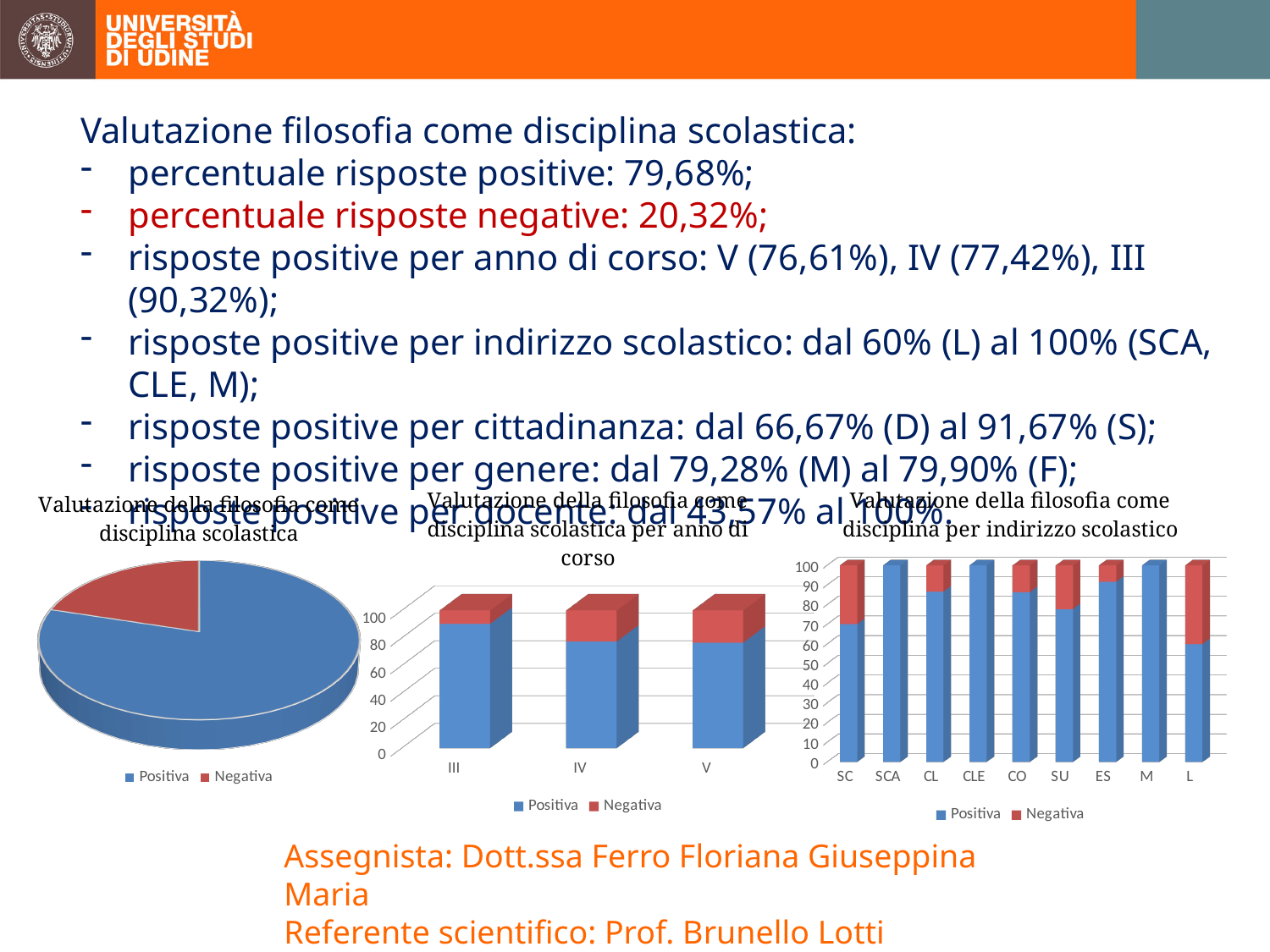
In the right chart (per indirizzo scolastico), how many categories are shown on the x axis? 9 In the right chart (per indirizzo scolastico), which category has the lowest Positiva value? L What kind of chart is the left chart titled 'Valutazione della filosofia come disciplina scolastica'? pie chart In the middle chart (per anno di corso), how many categories are shown on the x axis? 3 What kind of chart is the middle chart titled 'Valutazione della filosofia come disciplina scolastica per anno di corso'? bar chart In the middle chart (per anno di corso), which year has the highest Positiva value? III In the right chart (per indirizzo scolastico), what is the total height of the stacked bar for SCA? 100 In the middle chart (per anno di corso), is the Positiva value for III greater or less than 80? greater In the right chart (per indirizzo scolastico), is the Positiva value for L greater or less than 70? less In the right chart titled 'Valutazione della filosofia come disciplina per indirizzo scolastico', how many series does the legend list? 2 In the right chart (per indirizzo scolastico), which has the larger Positiva value, SC or CL? CL In the left pie chart, which slice is larger, Positiva or Negativa? Positiva